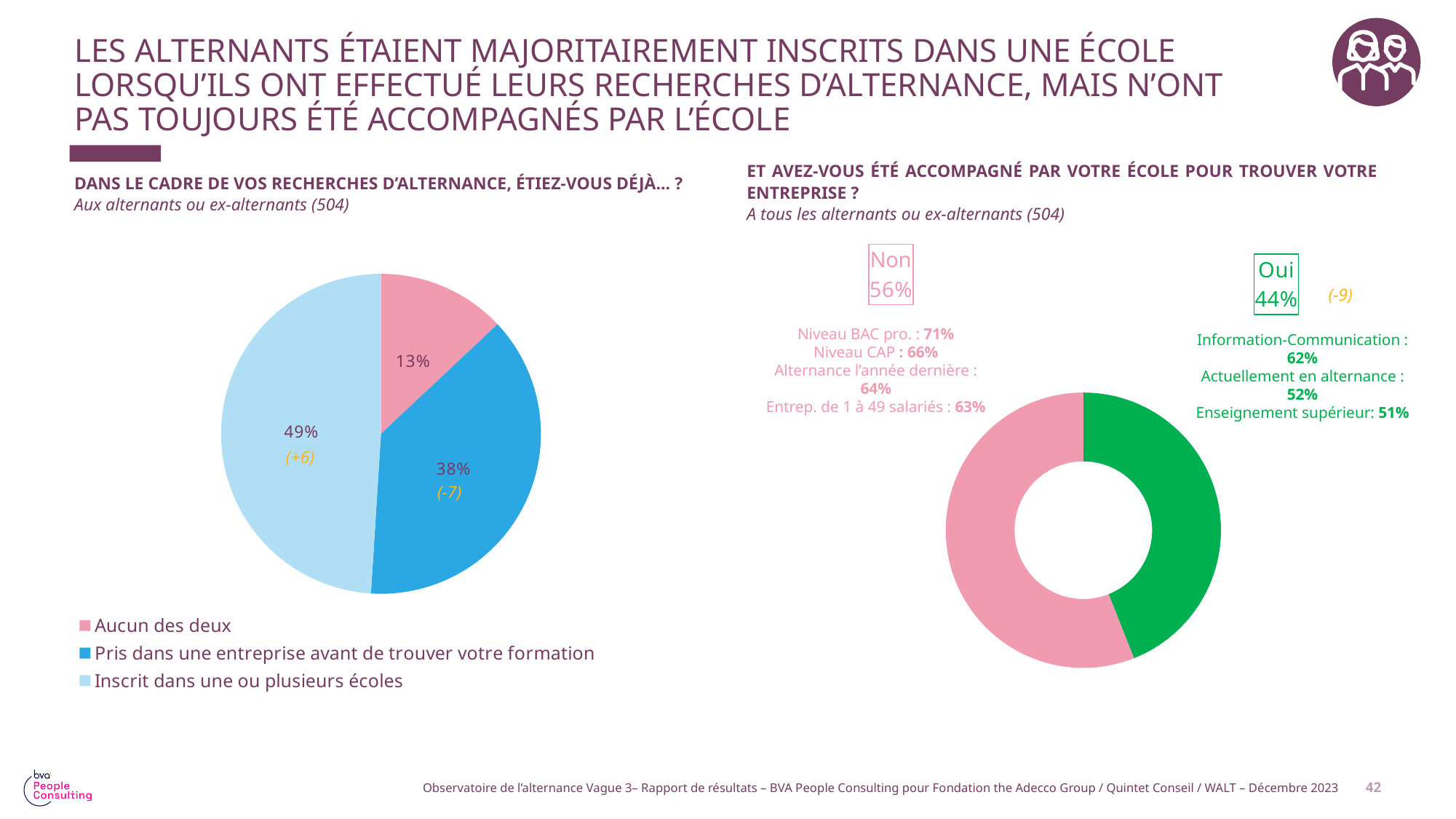
In the right donut chart, what share of respondents answered 'Oui'? 44% In the left pie chart, what share of respondents answered 'Inscrit dans une ou plusieurs écoles'? 49% In the left pie chart, which category has the largest share? Inscrit dans une ou plusieurs écoles What type of chart is shown on the left of the slide? Pie chart In the left pie chart, what is the difference between the share for 'Inscrit dans une ou plusieurs écoles' and the share for 'Pris dans une entreprise avant de trouver votre formation'? 11 points In the right donut chart, which answer is larger, 'Oui' or 'Non'? Non How many categories does the legend of the left pie chart list? 3 In the right donut chart, what is the difference between the 'Non' share and the 'Oui' share? 12 points In the right donut chart, what share of respondents answered 'Non'? 56% In the left pie chart, what share of respondents answered 'Aucun des deux'? 13% In the left pie chart, what share of respondents answered 'Pris dans une entreprise avant de trouver votre formation'? 38% In the left pie chart, which category has the smallest share? Aucun des deux